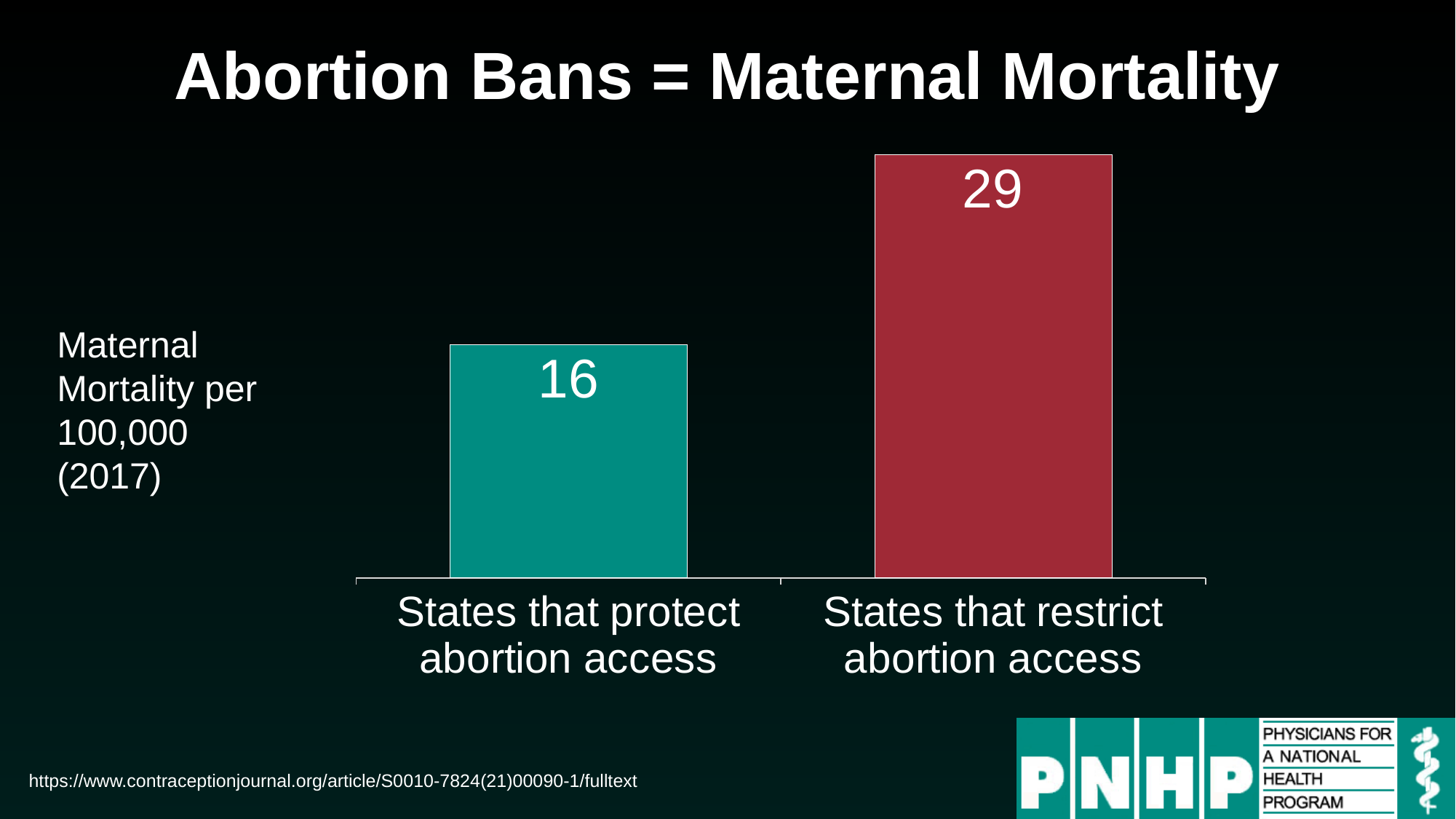
What is the maternal mortality per 100,000 for states that protect abortion access? 16 What year does the maternal mortality data on the chart refer to? 2017 How many categories are shown in the chart? 2 What kind of chart is shown on the slide? Bar chart What is the difference in maternal mortality per 100,000 between states that restrict abortion access and states that protect abortion access? 13 Which category has the higher maternal mortality rate? States that restrict abortion access Is the maternal mortality rate higher for states that protect abortion access or for states that restrict abortion access? States that restrict abortion access Which category has the lower maternal mortality rate? States that protect abortion access What is the maternal mortality per 100,000 for states that restrict abortion access? 29 What is the title of the slide containing the chart? Abortion Bans = Maternal Mortality